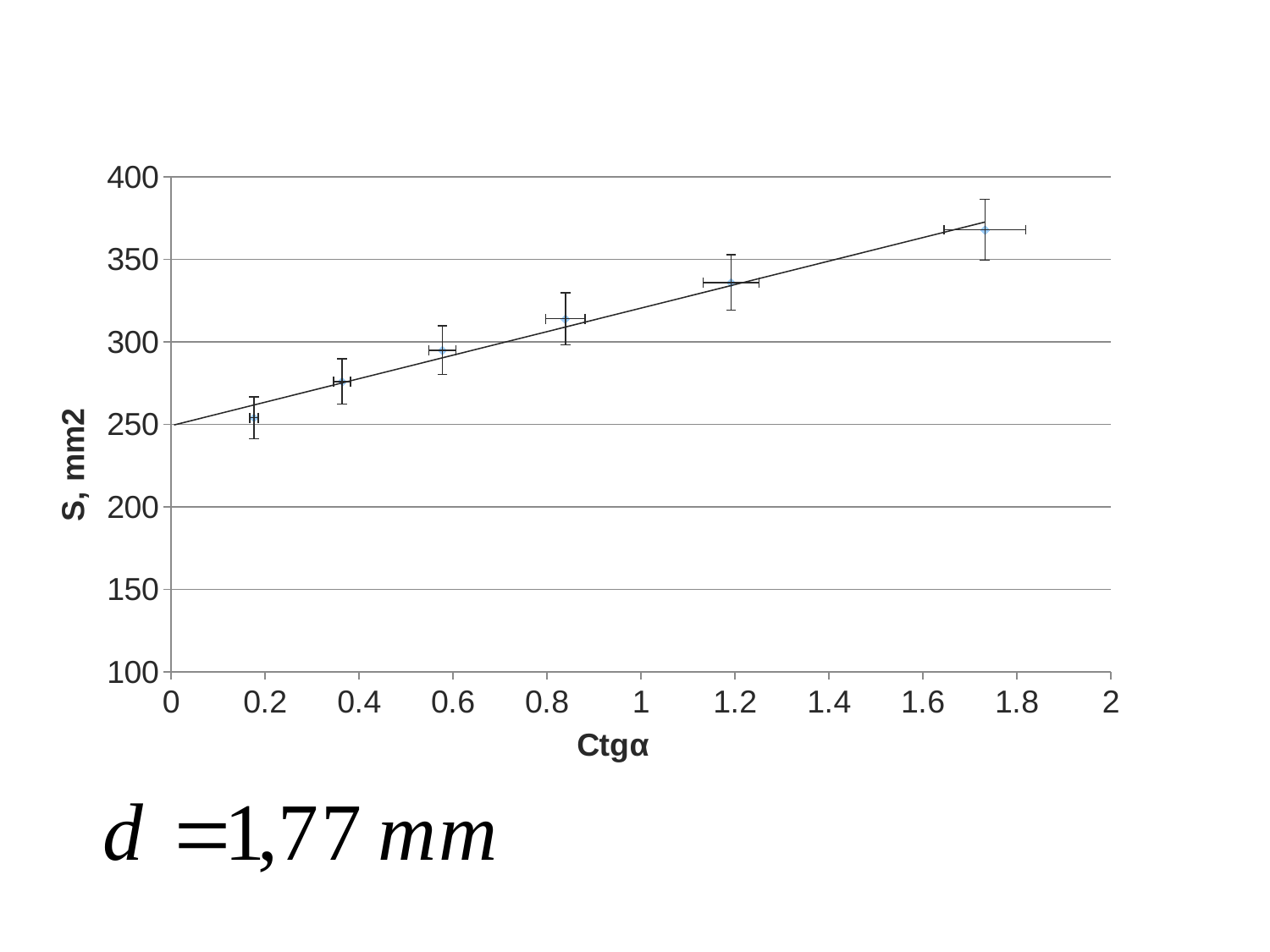
Do the S values rise or fall as Ctgα increases along the x axis? Rise Which data point has the lowest S value, the leftmost or the rightmost? The leftmost How many data points are plotted on the chart? 6 Is the S value of the data point near Ctgα = 1.7 greater or less than 350? greater What is the label of the vertical axis? S, mm2 What kind of chart is shown on the slide? Scatter chart Which data point has the highest S value, the leftmost or the rightmost? The rightmost What is the label of the horizontal axis? Ctgα Is the S value of the data point near Ctgα = 0.4 greater or less than 300? less Is the S value of the data point near Ctgα = 0.2 greater or less than 300? less